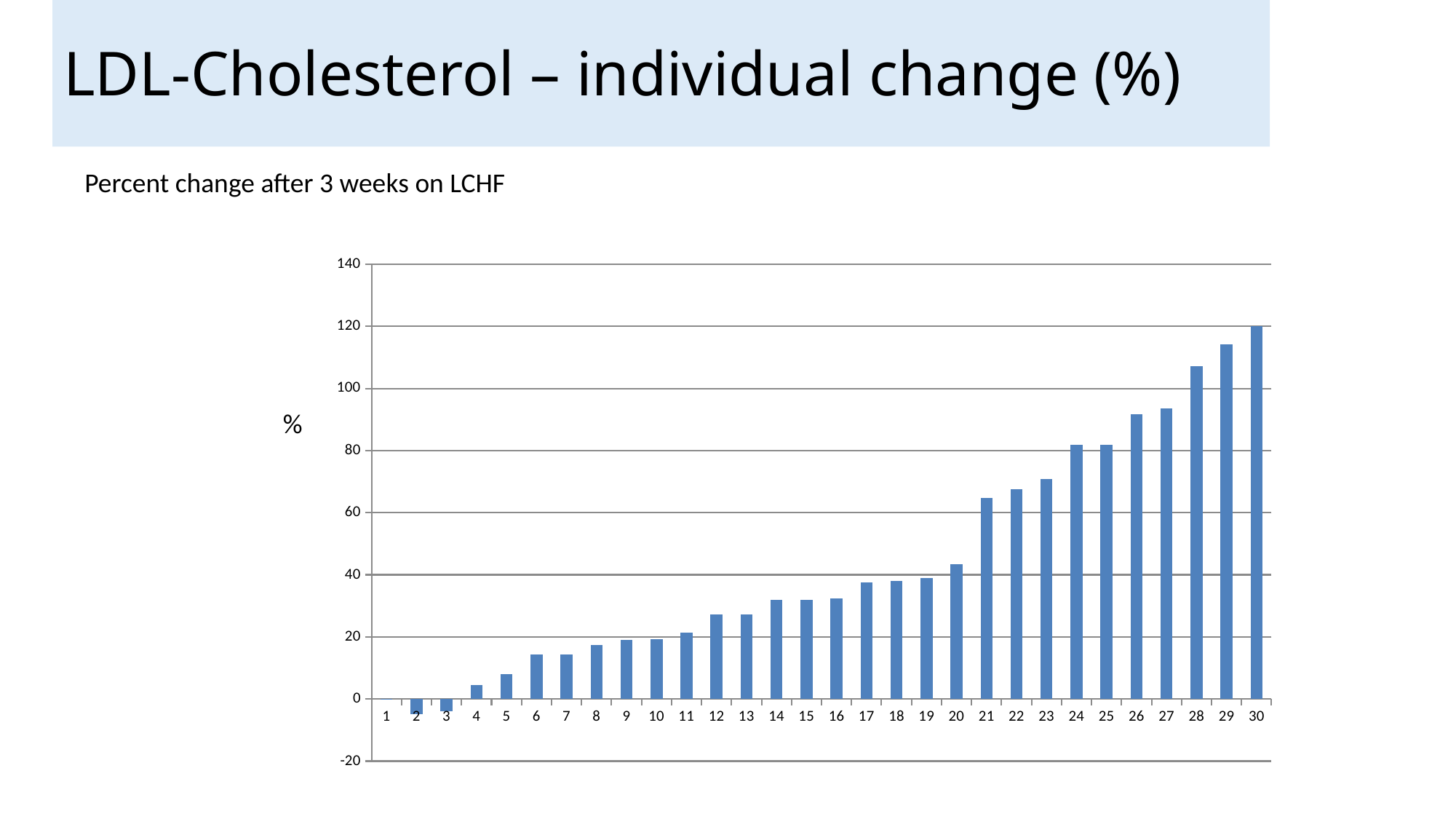
What is the title of the slide? LDL-Cholesterol – individual change (%) Which is larger, the value for individual 21 or individual 20? 21 Is the value for individual 28 greater or less than 100? greater Which individual has the highest LDL-cholesterol change? 30 Do the values rise or fall from left to right along the x axis? rise Is the value for individual 21 greater or less than 60? greater Is the value for individual 12 greater or less than 20? greater What is the label on the vertical axis of the chart? % How many bars (individuals) are plotted on the chart? 30 What kind of chart is shown on the slide? bar chart